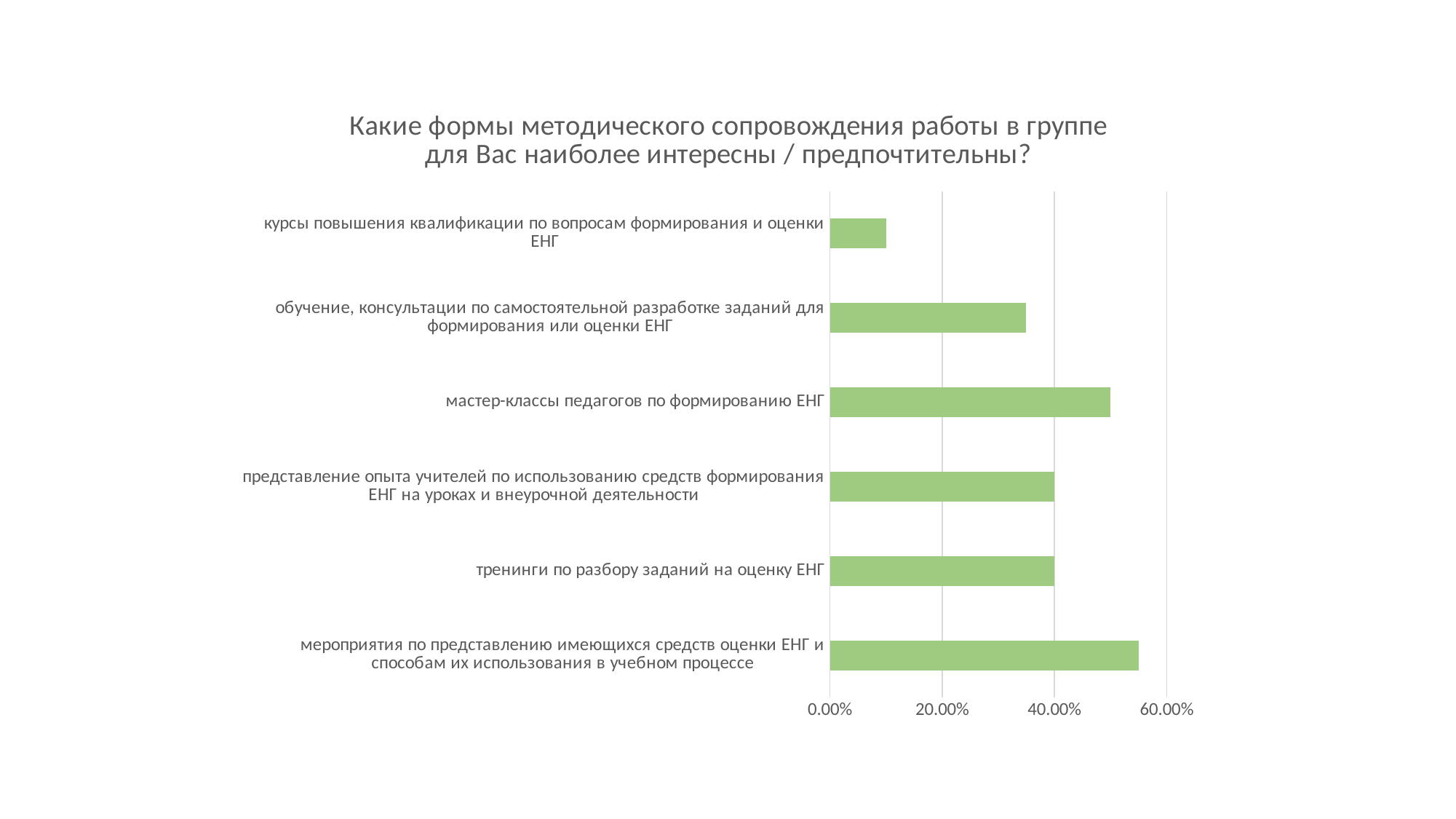
What is the value for 'тренинги по разбору заданий на оценку ЕНГ'? 40.00% Which category has the lowest value in the chart? курсы повышения квалификации по вопросам формирования и оценки ЕНГ Which has a larger value: 'мастер-классы педагогов по формированию ЕНГ' or 'обучение, консультации по самостоятельной разработке заданий для формирования или оценки ЕНГ'? мастер-классы педагогов по формированию ЕНГ What is the highest tick label shown on the horizontal axis of the chart? 60.00% Is the value for 'мероприятия по представлению имеющихся средств оценки ЕНГ и способам их использования в учебном процессе' greater or less than 40.00%? greater Is the value for 'мастер-классы педагогов по формированию ЕНГ' greater or less than 40.00%? greater How many categories (forms of methodological support) are plotted in the chart? 6 Is the value for 'курсы повышения квалификации по вопросам формирования и оценки ЕНГ' greater or less than 20.00%? less What kind of chart is shown on the slide? bar chart Which category has the highest value in the chart? мероприятия по представлению имеющихся средств оценки ЕНГ и способам их использования в учебном процессе What is the title of the chart? Какие формы методического сопровождения работы в группе для Вас наиболее интересны / предпочтительны?